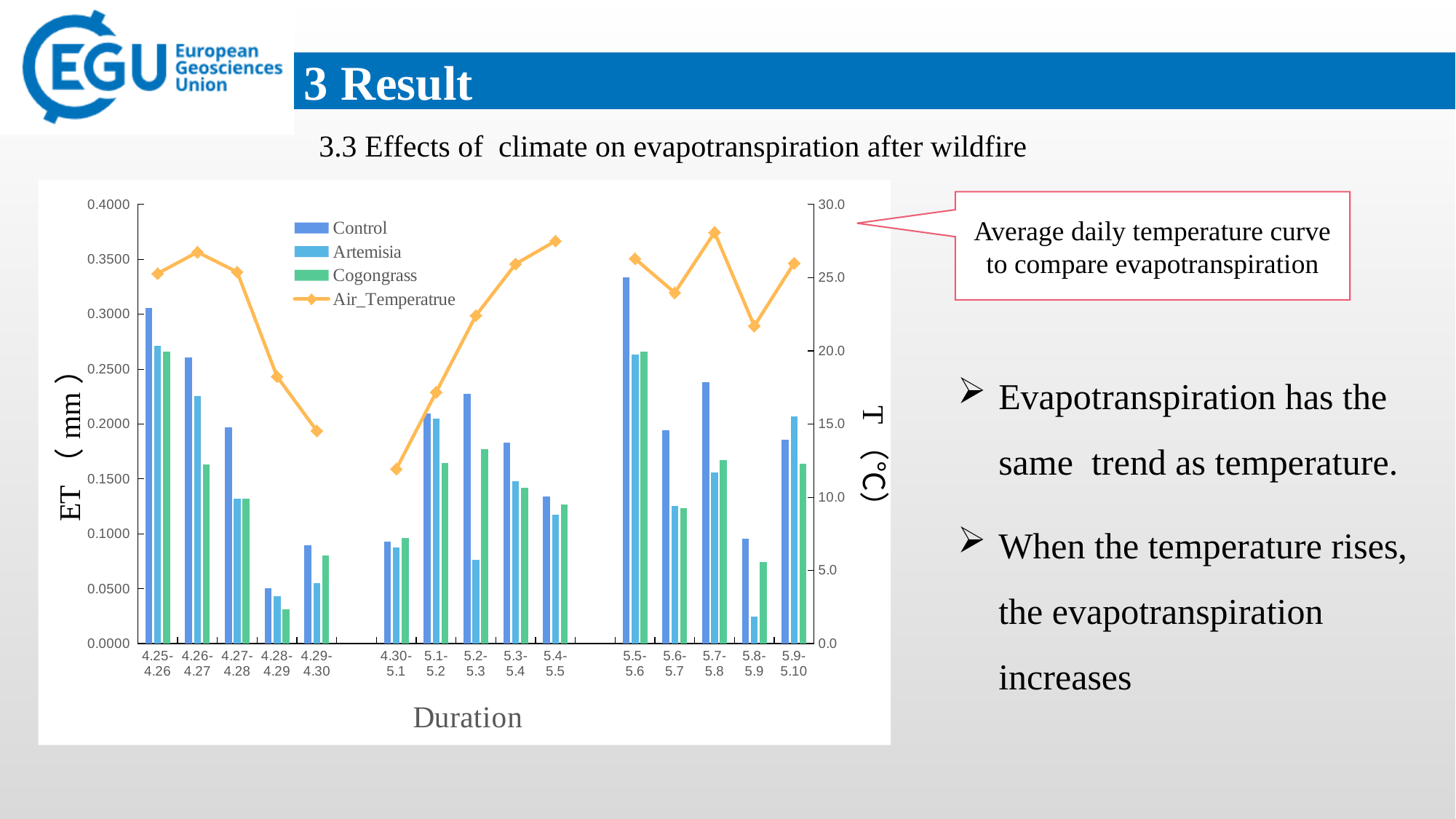
Does the Air_Temperatrue line rise or fall from 4.30-5.1 to 5.4-5.5? rise How many duration categories are shown on the x axis? 15 What is the title of the x axis? Duration Is the Air_Temperatrue value for 4.30-5.1 greater or less than 15.0? less Is the Control value for 5.5-5.6 greater or less than 0.3000? greater How many series does the chart legend list? 4 In which duration is the Artemisia bar lowest? 5.8-5.9 In which duration is the Control bar highest? 5.5-5.6 For 4.26-4.27, which is larger: the Control bar or the Cogongrass bar? Control What kind of chart is this? Bar chart with a line series In which duration is the Cogongrass bar lowest? 4.28-4.29 Is the Air_Temperatrue value for 5.7-5.8 greater or less than 25.0? greater